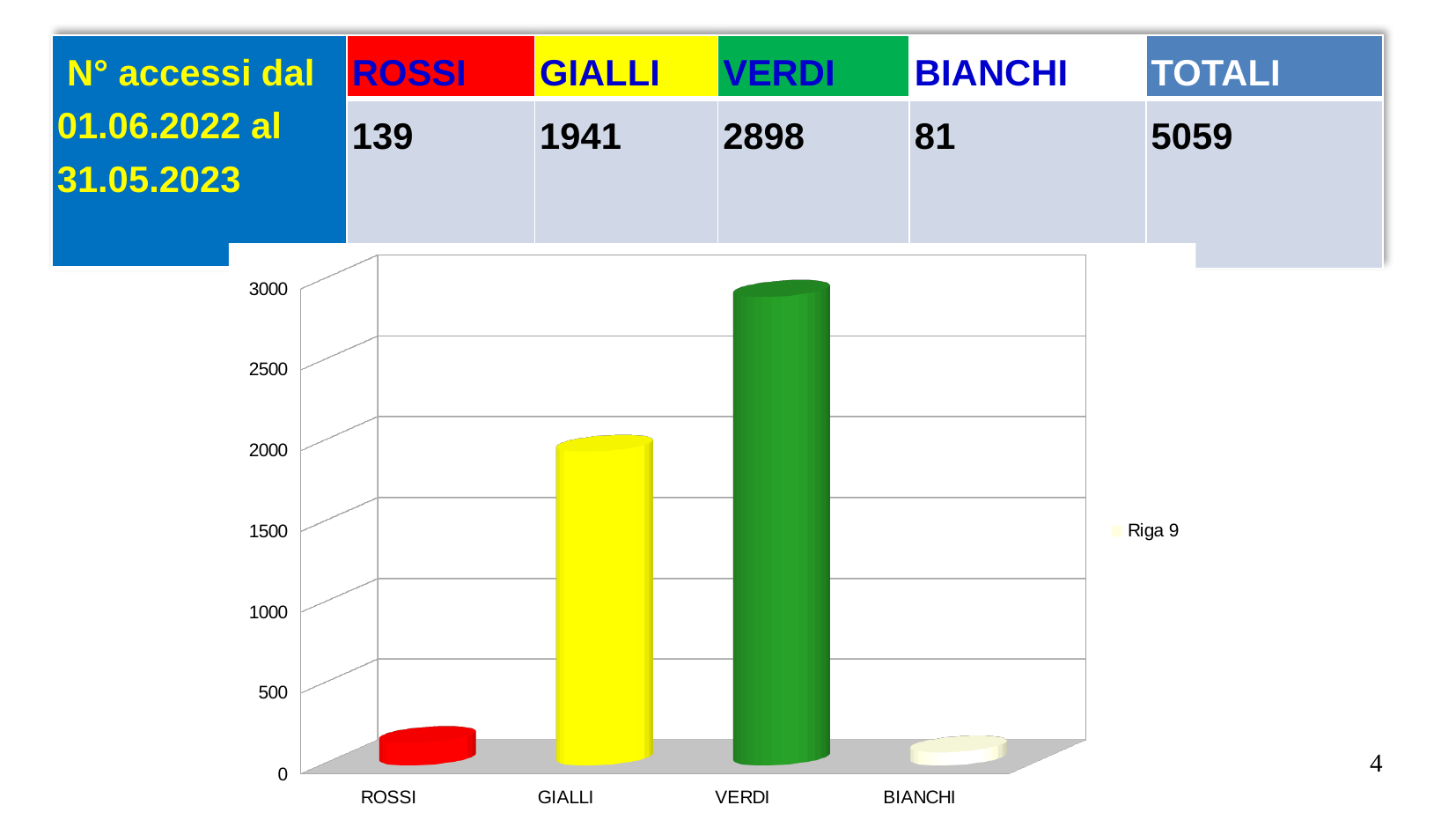
According to the table on the slide, what is the number of accesses for VERDI? 2898 Is the bar for VERDI greater or less than 2500? greater Is the bar for ROSSI greater or less than 500? less Which bar is taller, GIALLI or ROSSI? GIALLI What is the legend entry shown next to the chart? Riga 9 According to the table on the slide, what is the number of accesses for BIANCHI? 81 Which category has the shortest bar in the chart? BIANCHI Using the values in the table, what is the difference between VERDI and GIALLI? 957 Which category has the tallest bar in the chart? VERDI Is the bar for GIALLI greater or less than 1500? greater What type of chart is shown on the slide? bar chart How many categories are shown on the x axis of the chart? 4